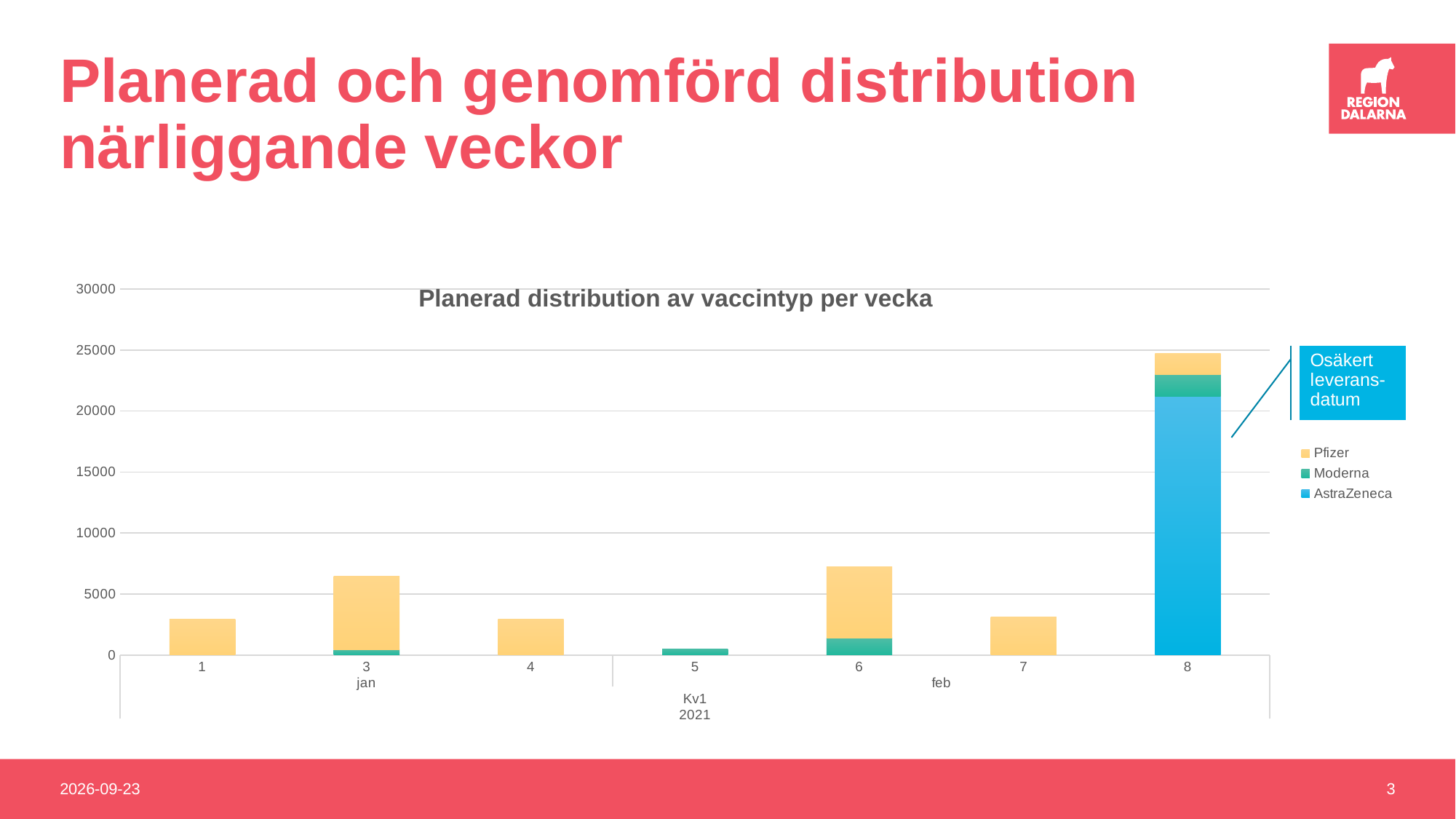
Which week has the highest total planned distribution? 8 What kind of chart is shown on the slide? Stacked bar chart Is the total value for week 1 greater or less than 5000? less How many series does the chart legend list? 3 Which is larger, the total for week 6 or the total for week 7? Week 6 Which is larger, the total for week 1 or the total for week 3? Week 3 What is the title of the chart? Planerad distribution av vaccintyp per vecka Which week has the lowest total planned distribution? 5 How many weeks (bars) are plotted on the x axis? 7 Which vaccine series appears only in week 8? AstraZeneca Is the total value for week 8 greater or less than 20000? greater Is the total value for week 3 greater or less than 5000? greater